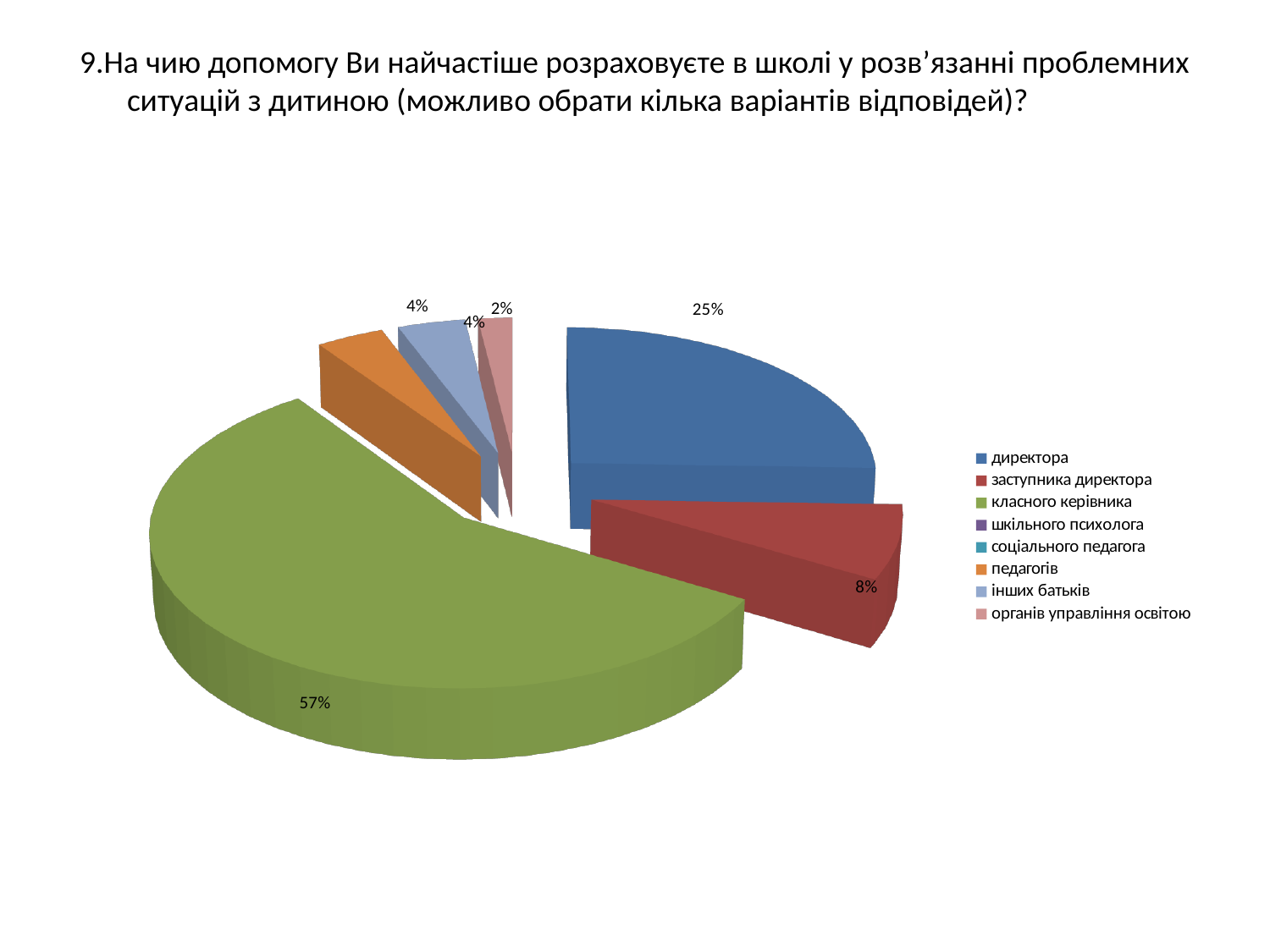
What share of the pie is labelled for класного керівника? 57% Which category has the largest slice of the pie? класного керівника Which slice is larger: директора or заступника директора? директора What colour is the slice for класного керівника? green What share of the pie is labelled for органів управління освітою? 2% What share of the pie is labelled for заступника директора? 8% What share of the pie is labelled for педагогів? 4% What share of the pie is labelled for директора? 25% How many entries does the legend list? 8 Which of the labelled slices is the smallest? органів управління освітою What kind of chart is shown on the slide? pie chart How many percentage points larger is the slice for класного керівника than the slice for директора? 32